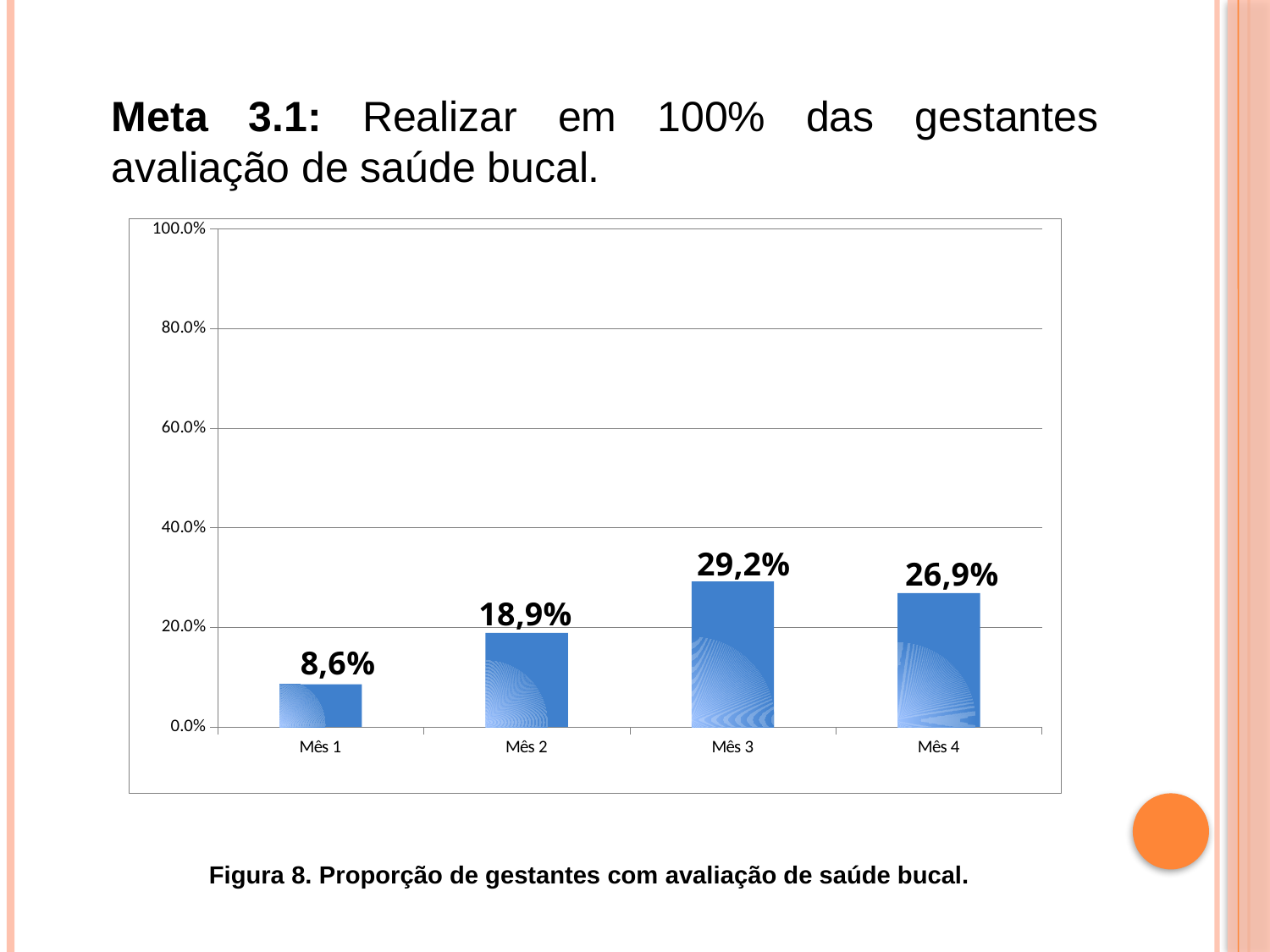
Which is larger, the value for Mês 2 or the value for Mês 4? Mês 4 What is the difference between the values for Mês 3 and Mês 4? 2,3% How many months are shown on the x axis? 4 What is the difference between the values for Mês 2 and Mês 1? 10,3% Which month has the highest value? Mês 3 What is the value for Mês 1? 8,6% What is the caption of the figure below the chart? Figura 8. Proporção de gestantes com avaliação de saúde bucal. What is the value for Mês 3? 29,2% What is the value for Mês 4? 26,9% Is the value for Mês 3 greater or less than 20.0%? greater Which month has the lowest value? Mês 1 What kind of chart is shown on the slide? bar chart